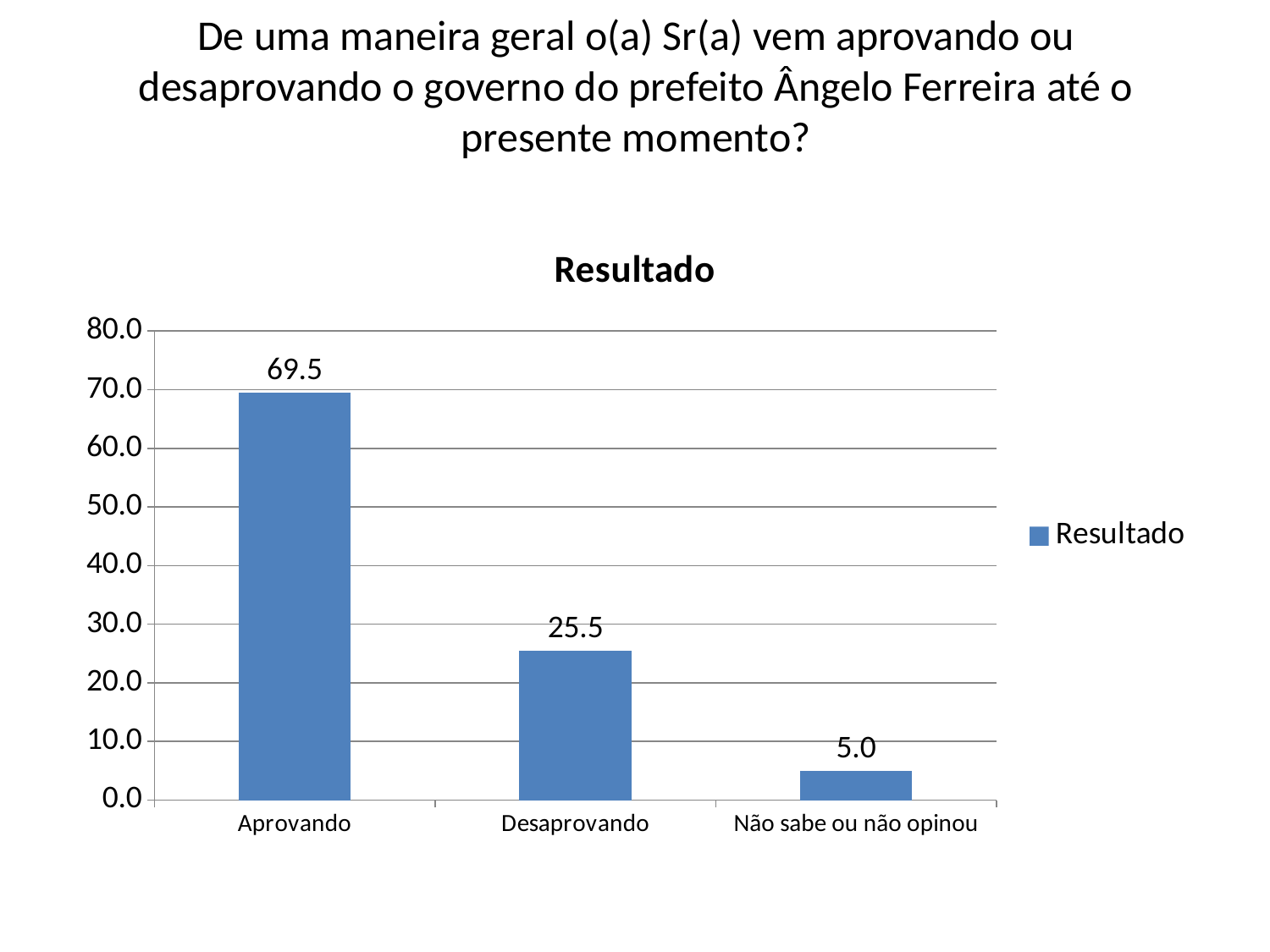
What is the value for Não sabe ou não opinou? 5.0 What is the difference between the values for Desaprovando and Não sabe ou não opinou? 20.5 How many series does the legend list? 1 How many categories are shown on the x axis? 3 Which category has the highest value? Aprovando What is the value for Desaprovando? 25.5 Is the value for Aprovando greater or less than 60.0? greater What kind of chart is shown? bar chart What is the difference between the values for Aprovando and Desaprovando? 44.0 Which is larger, the value for Desaprovando or the value for Não sabe ou não opinou? Desaprovando Which category has the lowest value? Não sabe ou não opinou What is the value for Aprovando? 69.5